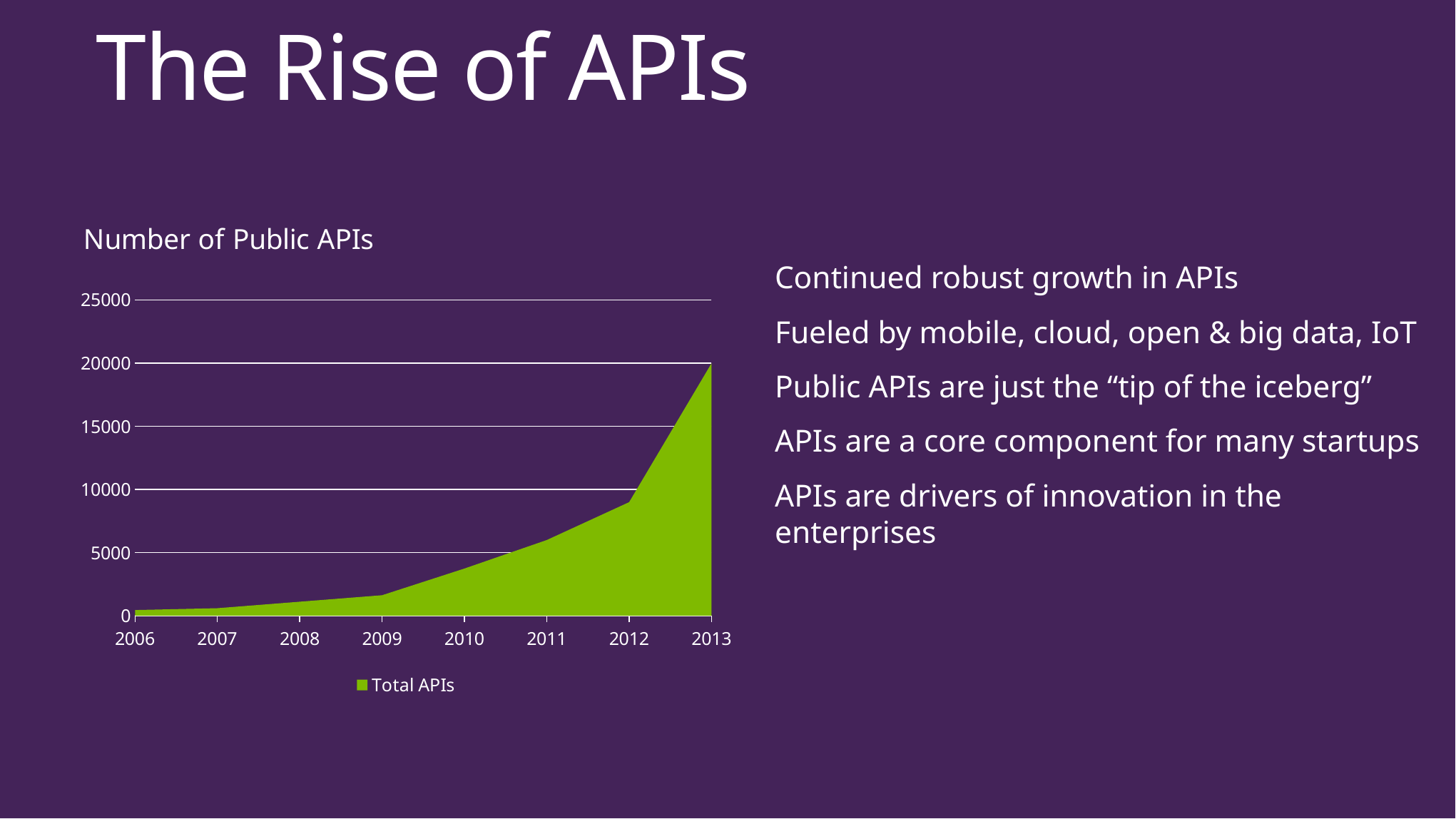
Which year has the lowest number of public APIs? 2006 How many years are shown on the x axis of the chart? 8 What kind of chart is shown on the slide? Area chart How many series does the legend list? 1 Is the value for 2013 greater or less than 15000? greater Which year has the highest number of public APIs? 2013 Is the value for 2012 greater or less than 10000? less What series name does the chart legend show? Total APIs Which year has a larger number of public APIs, 2009 or 2012? 2012 What is the title of the chart? Number of Public APIs Do the values rise or fall from 2006 to 2013? Rise Is the value for 2010 greater or less than 5000? less